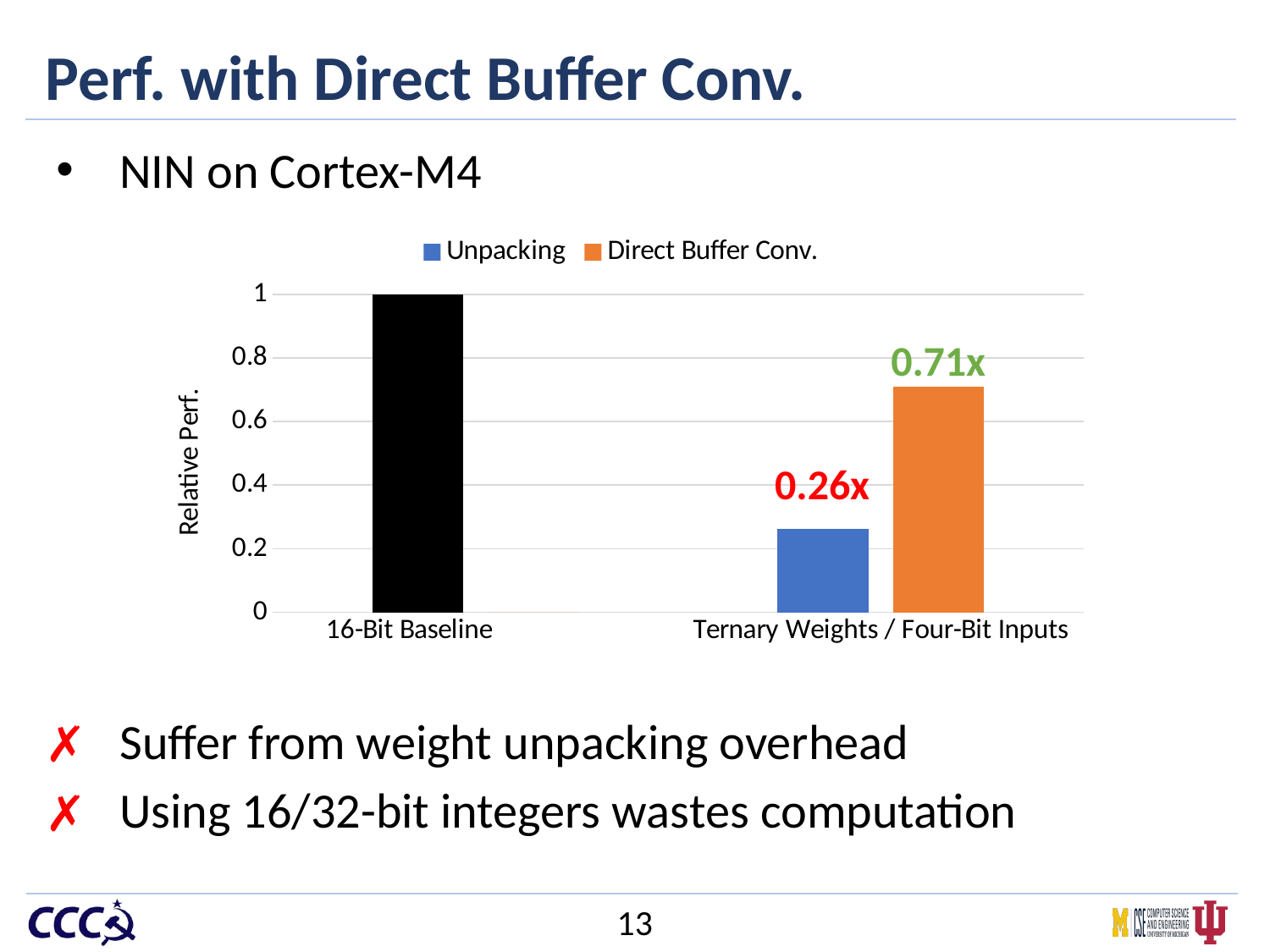
Which series has the higher value for Ternary Weights / Four-Bit Inputs, Unpacking or Direct Buffer Conv.? Direct Buffer Conv. What are the two series named in the chart legend? Unpacking and Direct Buffer Conv. What is the data label on the Direct Buffer Conv. bar for Ternary Weights / Four-Bit Inputs? 0.71x What kind of chart is shown on the slide? bar chart Which bar in the chart is the highest? 16-Bit Baseline Is the Direct Buffer Conv. value for Ternary Weights / Four-Bit Inputs greater or less than 0.6? greater How many categories are shown on the x axis of the chart? 2 How many series does the chart legend list? 2 What is the label of the y axis of the chart? Relative Perf. What is the relative performance of the 16-Bit Baseline bar? 1 Which bar in the chart is the lowest? Unpacking (Ternary Weights / Four-Bit Inputs) What is the data label on the Unpacking bar for Ternary Weights / Four-Bit Inputs? 0.26x